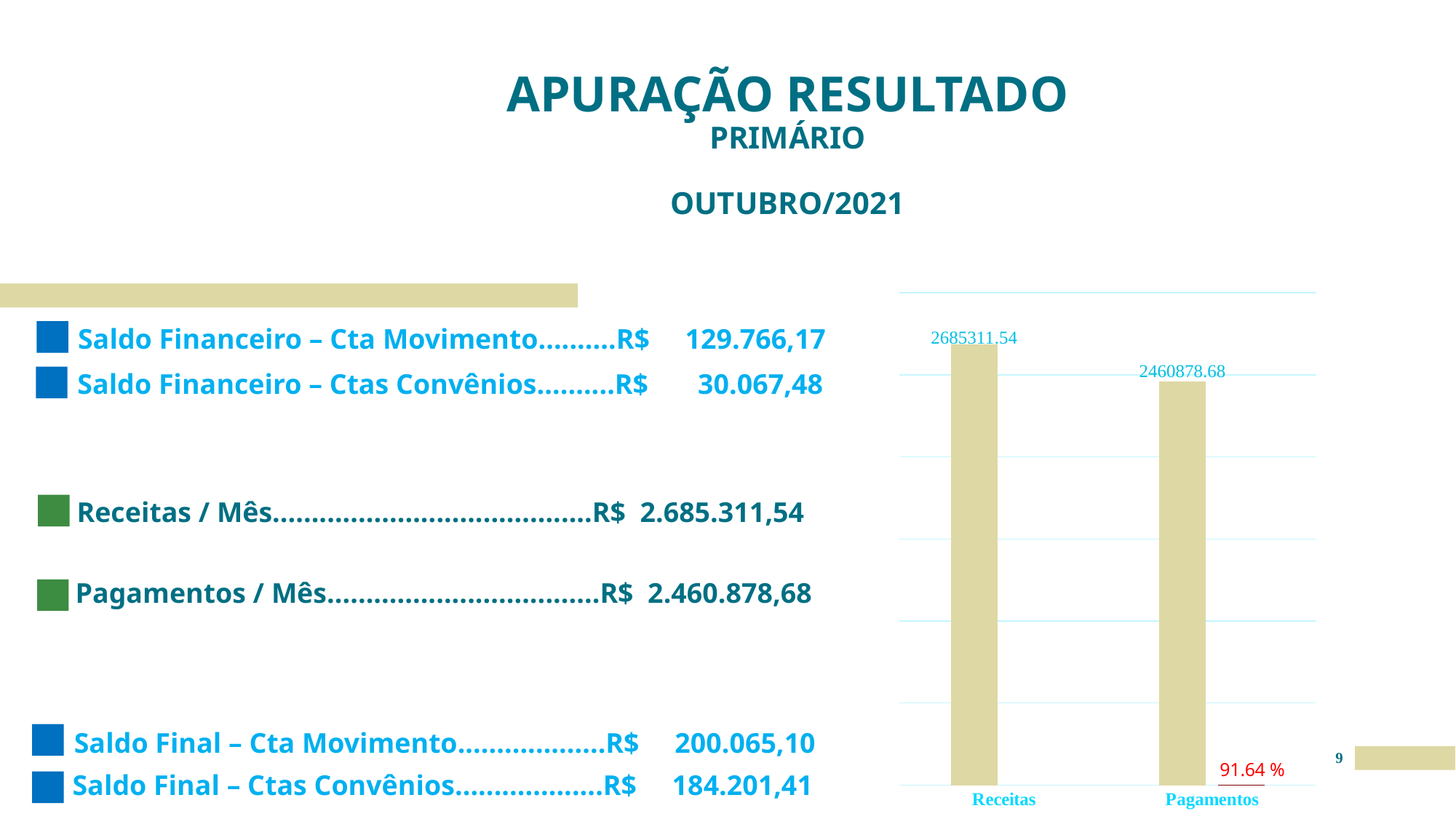
Which category has the highest bar in the chart? Receitas What is the difference between the Receitas and Pagamentos values in the chart? 224432.86 What is the value of the Receitas bar in the chart? 2685311.54 Which category has the lowest bar in the chart? Pagamentos What percentage is annotated in red near the Pagamentos bar? 91.64 % What kind of chart is shown on the slide? Bar chart How many bars are plotted in the chart? 2 Which is larger in the chart, Receitas or Pagamentos? Receitas What is the value of the Pagamentos bar in the chart? 2460878.68 Do the values rise or fall from Receitas to Pagamentos along the x axis? Fall What are the category labels on the x axis of the chart? Receitas, Pagamentos